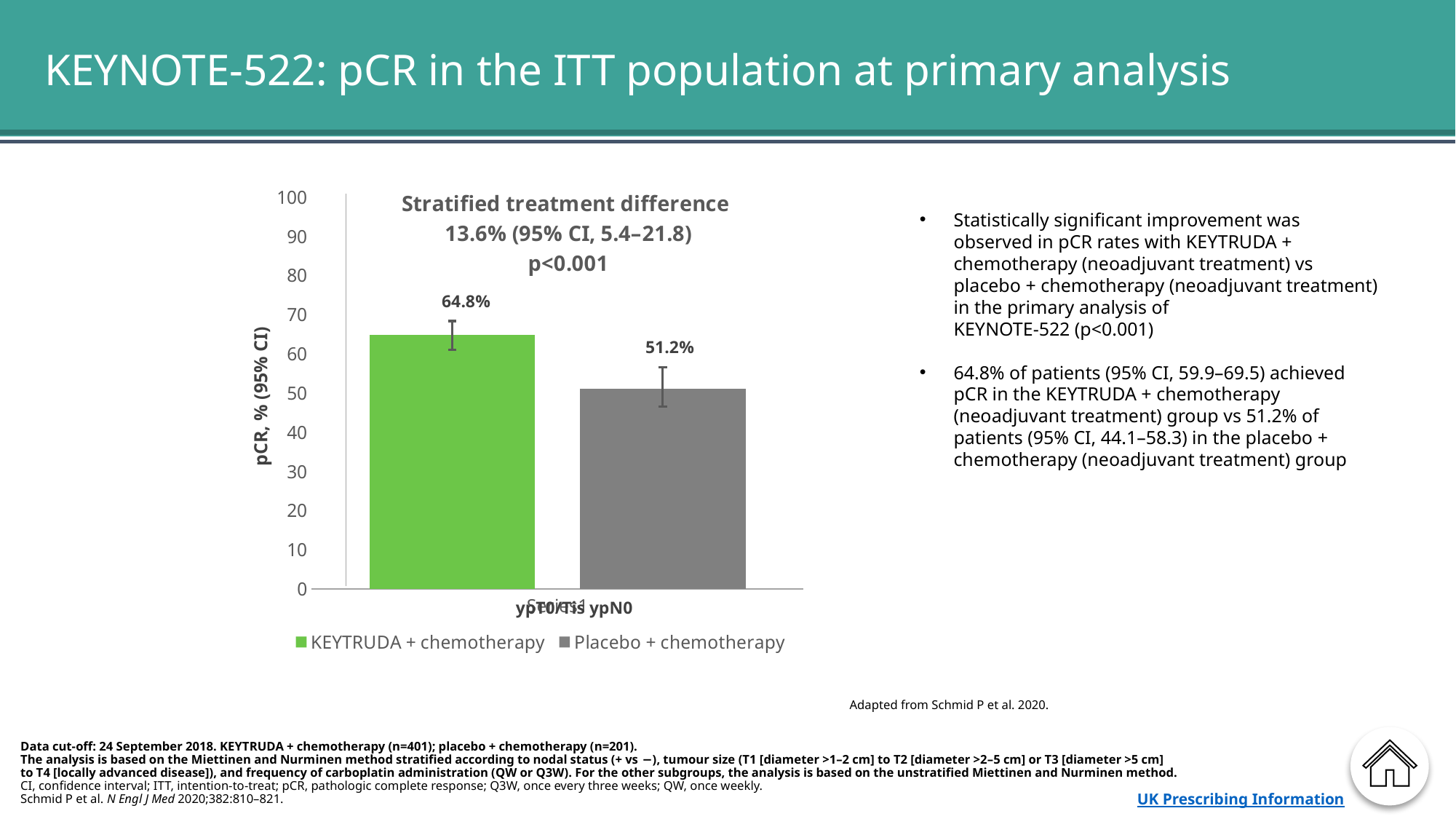
What is the pCR rate shown for the Placebo + chemotherapy bar? 51.2% How many bars are plotted in the chart? 2 What is the pCR rate shown for the KEYTRUDA + chemotherapy bar? 64.8% Which treatment group has the higher pCR rate in the chart? KEYTRUDA + chemotherapy What is the label of the y axis of the chart? pCR, % (95% CI) Which treatment group has the lower pCR rate in the chart? Placebo + chemotherapy Is the value for Placebo + chemotherapy greater or less than 60? less What type of chart is shown on the slide? Bar chart Is the value for KEYTRUDA + chemotherapy greater or less than 60? greater What is the difference in pCR rate between the KEYTRUDA + chemotherapy bar and the Placebo + chemotherapy bar? 13.6% Is the pCR rate for KEYTRUDA + chemotherapy larger or smaller than that for Placebo + chemotherapy? larger How many series does the chart legend list? 2